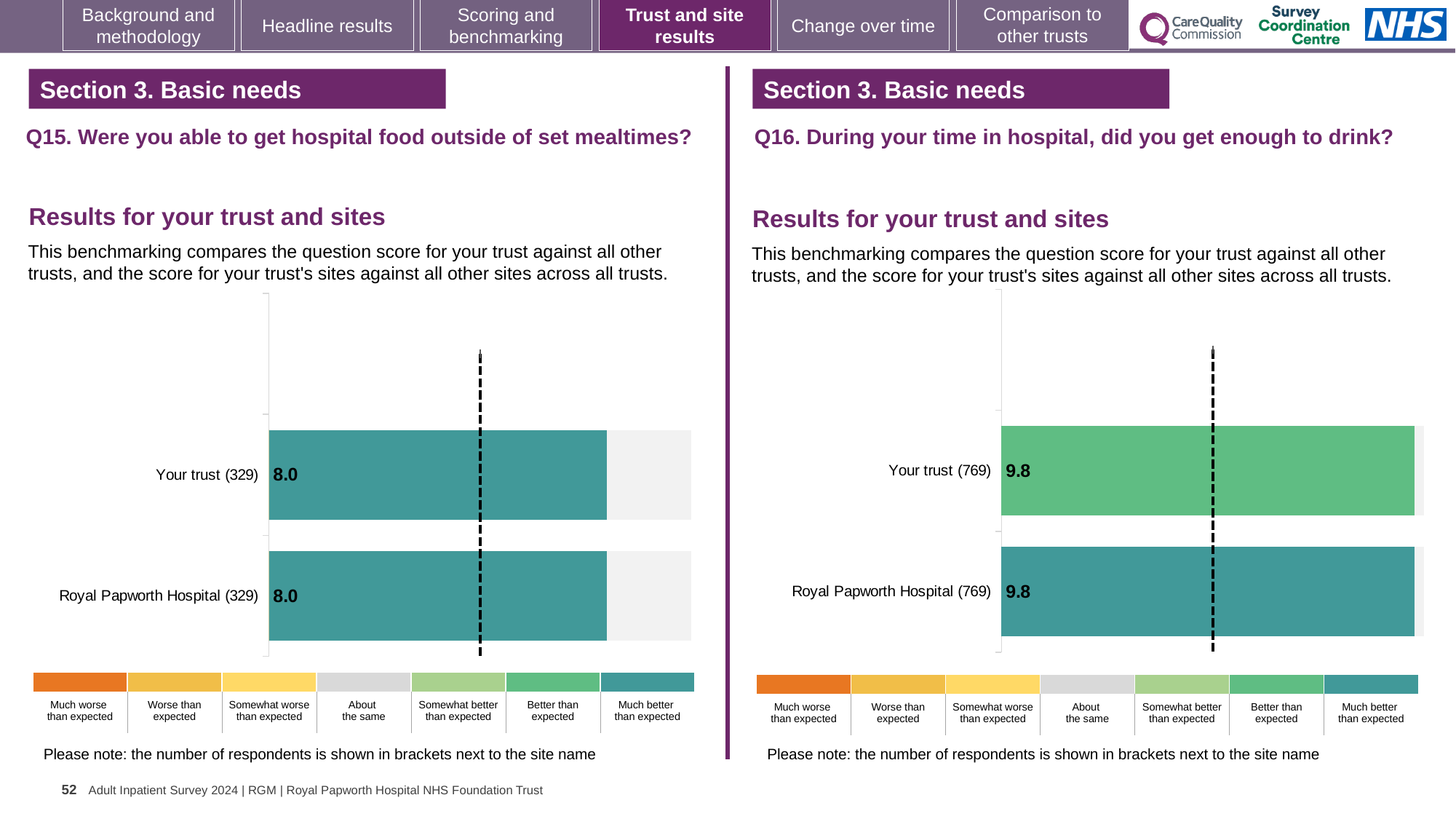
On the Q16 chart (right), which legend category does the colour of the Your trust bar correspond to? Better than expected On the Q16 chart (right), what is the difference between the score for Your trust and the score for Royal Papworth Hospital? 0.0 On the Q15 chart (left), what is the score for Your trust? 8.0 On the Q15 chart (left), how many bars are plotted? 2 On the Q16 chart (right), what is the score for Your trust? 9.8 On the Q15 chart (left), how many respondents are shown in brackets for Your trust? 329 On the Q16 chart (right), how many categories does the colour legend below the chart list? 7 On the Q16 chart (right), how many respondents are shown in brackets for Royal Papworth Hospital? 769 What kind of chart is the Q16 chart (right)? Bar chart On the Q15 chart (left), what is the score for Royal Papworth Hospital? 8.0 On the Q16 chart (right), how many bars are plotted? 2 On the Q16 chart (right), what is the score for Royal Papworth Hospital? 9.8